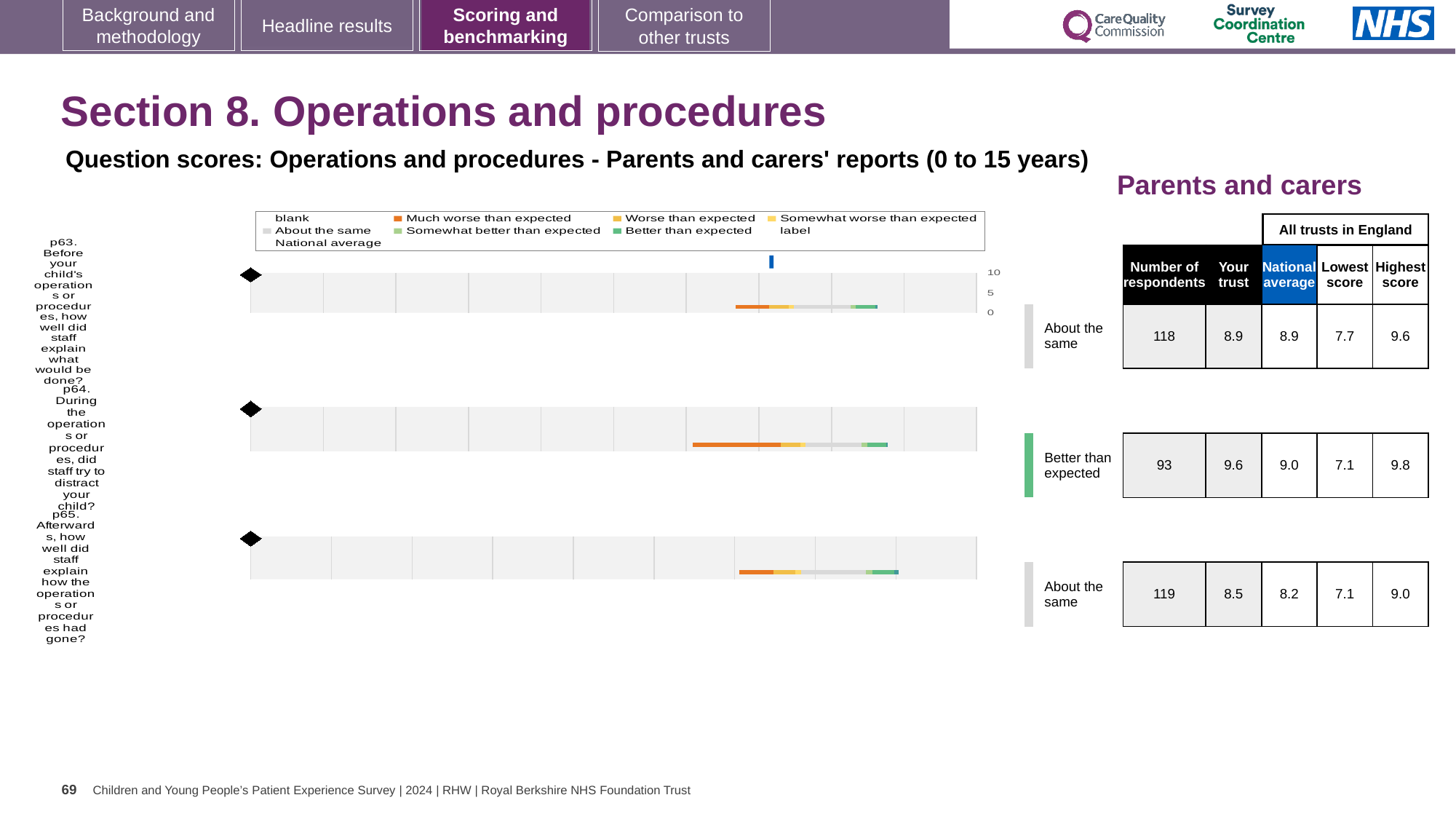
What is the difference between the 'Your trust' score and the national average for question p64? 0.6 What benchmark category is shown for question p64? Better than expected How many respondents answered question p63 (Before your child's operations or procedures, how well did staff explain what would be done?)? 118 What is the highest score across all trusts in England for question p64? 9.8 What kind of chart is shown on the slide? Bar chart What is the national average score for question p65 (Afterwards, how well did staff explain how the operations or procedures had gone?)? 8.2 How many questions are plotted on the chart? 3 What is the 'Your trust' score for question p64 (During the operations or procedures, did staff try to distract your child?)? 9.6 What is the lowest score across all trusts in England for question p63? 7.7 Which question has the lowest number of respondents? p64 Which has the higher 'Your trust' score, question p63 or question p65? p63 Which question has the highest 'Your trust' score? p64